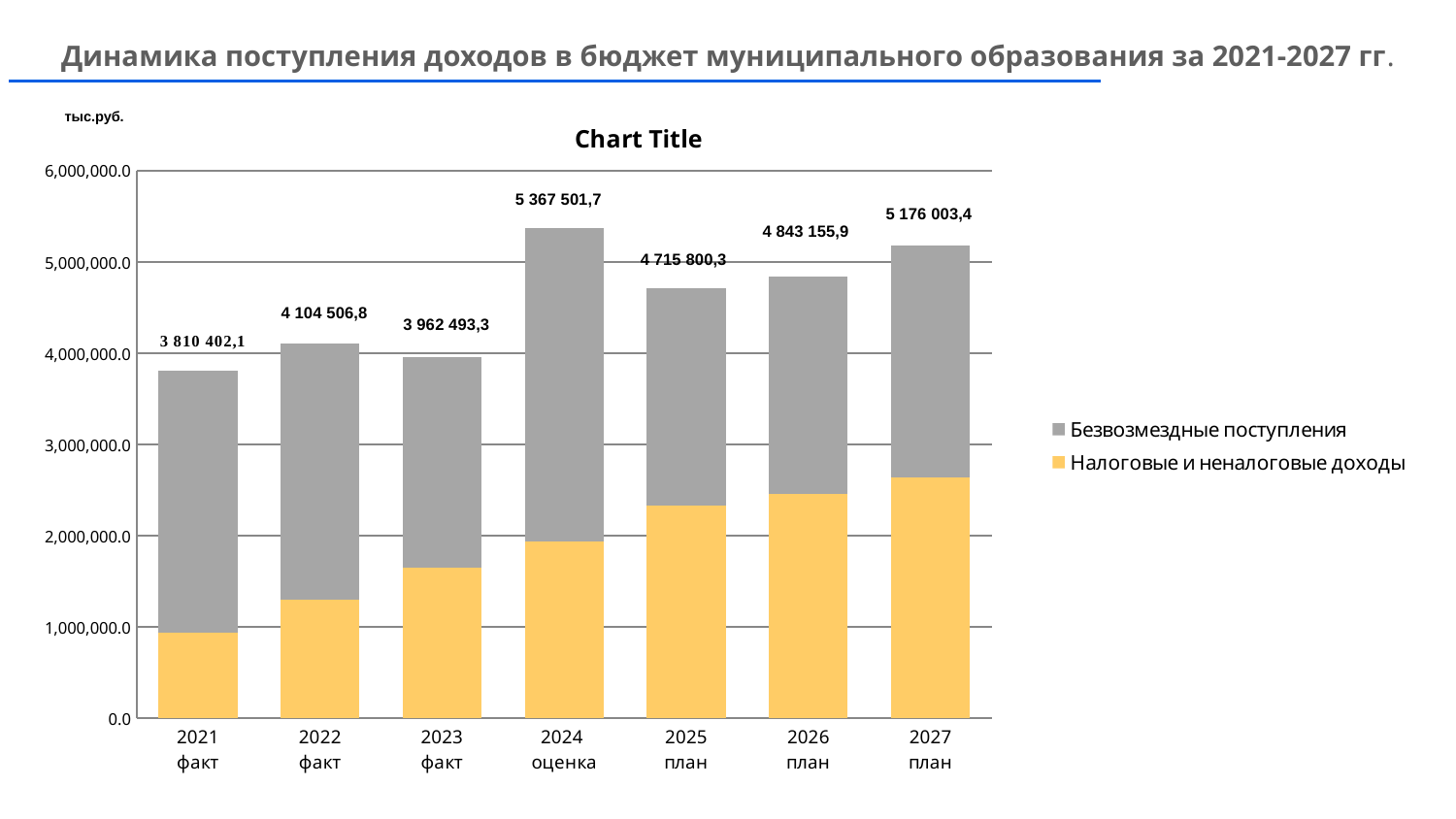
Which total is larger, 2022 факт or 2023 факт? 2022 факт What kind of chart is shown on the slide? Stacked bar chart Do the Налоговые и неналоговые доходы values rise or fall from 2021 to 2027? rise How many bars (years) are plotted on the chart? 7 Which year has the lowest total value? 2021 факт Which year has the highest total value? 2024 оценка Which series is shown in gray in the legend? Безвозмездные поступления What is the difference between the total for 2027 план and the total for 2026 план? 332 847,5 Is the value of Налоговые и неналоговые доходы for 2027 план greater or less than 2,000,000.0? greater How many series does the legend list? 2 What is the total value labelled above the bar for 2024 оценка? 5 367 501,7 What is the total value labelled above the bar for 2021 факт? 3 810 402,1